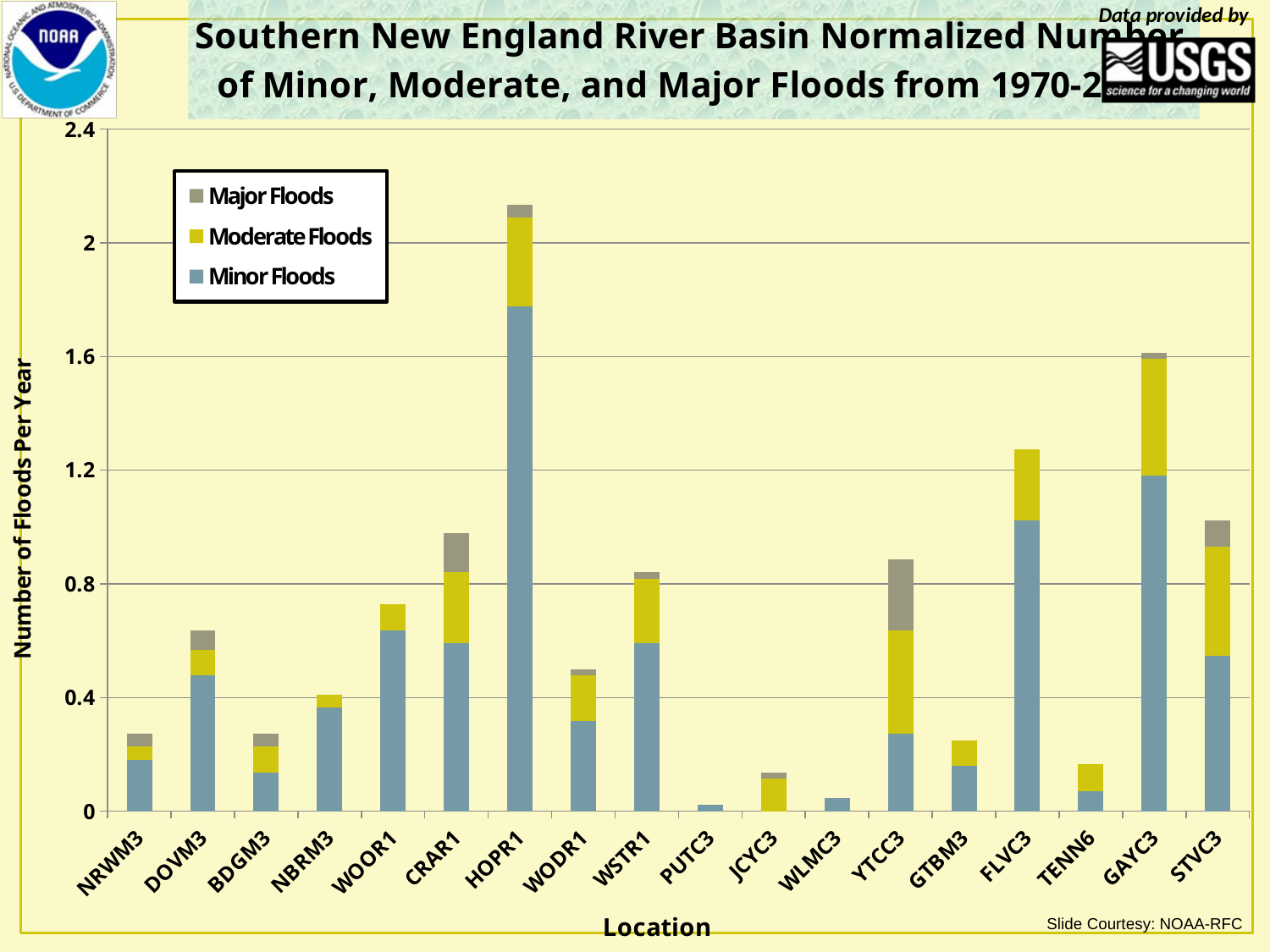
Is the total value for WOOR1 greater or less than 0.8? less How many locations are shown along the x axis? 18 Which location has the lowest total number of floods per year? PUTC3 Which location has the highest total number of floods per year? HOPR1 What is the label on the y axis? Number of Floods Per Year Is the total value for HOPR1 greater or less than 2? greater Which has a larger total number of floods per year, FLVC3 or STVC3? FLVC3 What kind of chart is shown on the slide? Stacked bar chart Is the total value for NRWM3 greater or less than 0.4? less How many series does the legend list? 3 Which location has the largest Major Floods segment? YTCC3